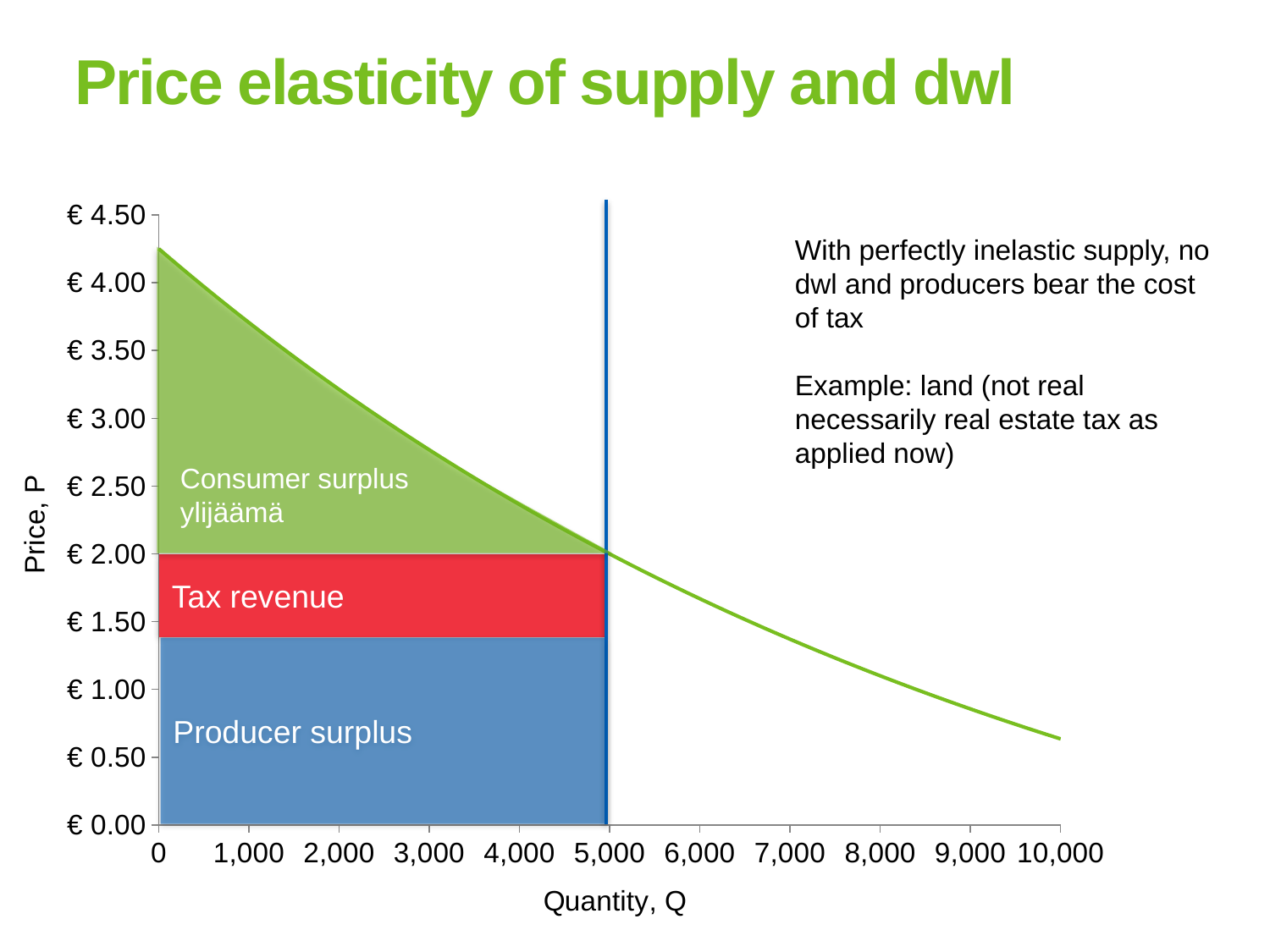
What kind of chart is shown on the slide? line chart What is the label of the vertical axis? Price, P What is the label of the horizontal axis? Quantity, Q Does the green demand curve rise or fall as quantity increases? fall At what price does the green demand curve cross the vertical blue supply line? € 2.00 At what quantity is the vertical blue supply line drawn? 5,000 How many shaded regions are labelled in the chart? 3 Is the price on the demand curve at a quantity of 0 greater or less than € 4.00? greater Is the price on the demand curve at a quantity of 3,000 greater or less than € 2.50? greater Is the price on the demand curve at a quantity of 10,000 greater or less than € 1.00? less Which shaded region is coloured red? Tax revenue